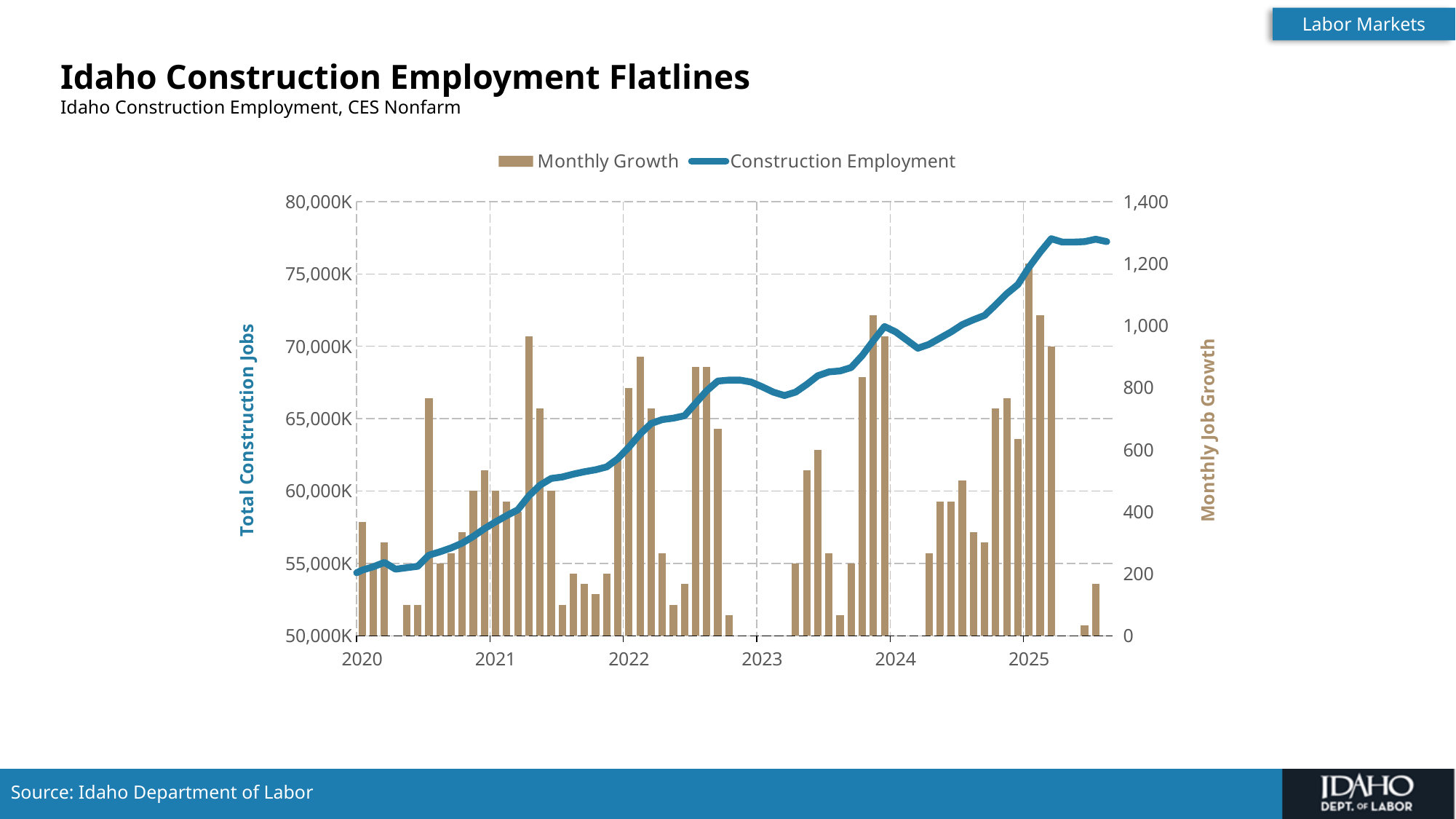
Is the tallest Monthly Growth bar greater or less than 1,000? greater What is the title of the chart? Idaho Construction Employment Flatlines Which is higher: the Construction Employment line at the start of 2025 or at the start of 2020? Start of 2025 How many year labels are shown on the x axis? 6 Which series is drawn as a line? Construction Employment Is the Construction Employment value at the start of 2024 greater or less than 75,000K? less Is the Construction Employment value at the last point of the line greater or less than 75,000K? greater What kind of chart is shown on the slide? A combined bar and line chart How many series does the legend list? 2 Does the Construction Employment line generally rise or fall from 2020 to 2025? Rise